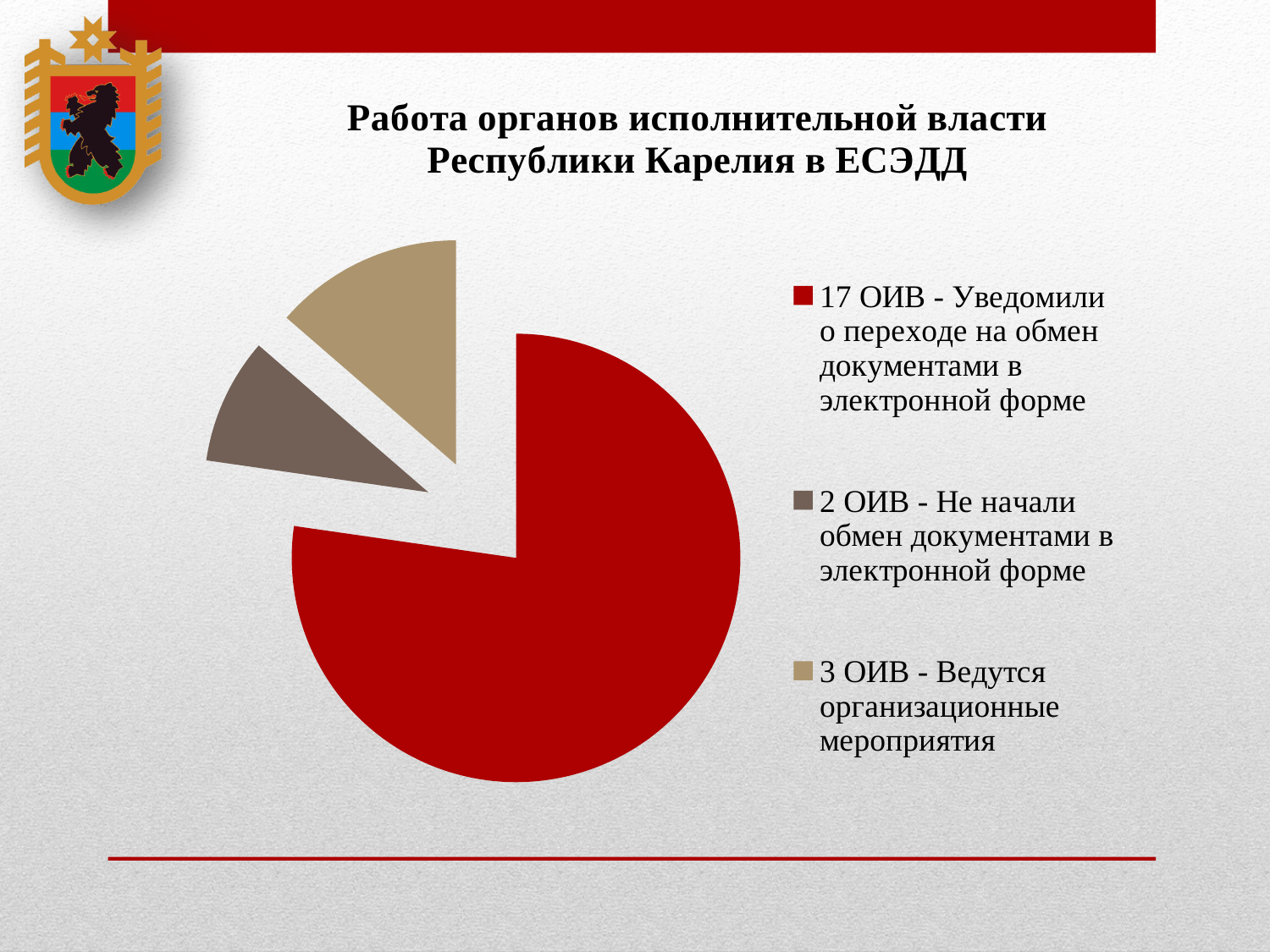
Which category has the largest slice of the pie chart? 17 ОИВ - Уведомили о переходе на обмен документами в электронной форме What kind of chart is shown on the slide? Pie chart How many ОИВ are carrying out organisational measures (Ведутся организационные мероприятия)? 3 ОИВ What is the difference between the number of ОИВ that notified about the transition and the number that have not started the exchange? 15 How many ОИВ notified about the transition to electronic document exchange (Уведомили о переходе на обмен документами в электронной форме)? 17 ОИВ Which is larger: the number of ОИВ carrying out organisational measures or the number that have not started the exchange? Ведутся организационные мероприятия (3 ОИВ) How many slices does the pie chart have? 3 How many ОИВ have not started electronic document exchange (Не начали обмен документами в электронной форме)? 2 ОИВ Which category has the smallest slice of the pie chart? 2 ОИВ - Не начали обмен документами в электронной форме What is the total number of ОИВ across all three slices of the pie chart? 22 How many entries does the legend of the pie chart list? 3 What colour is the slice for the ОИВ that notified about the transition to electronic document exchange? Red